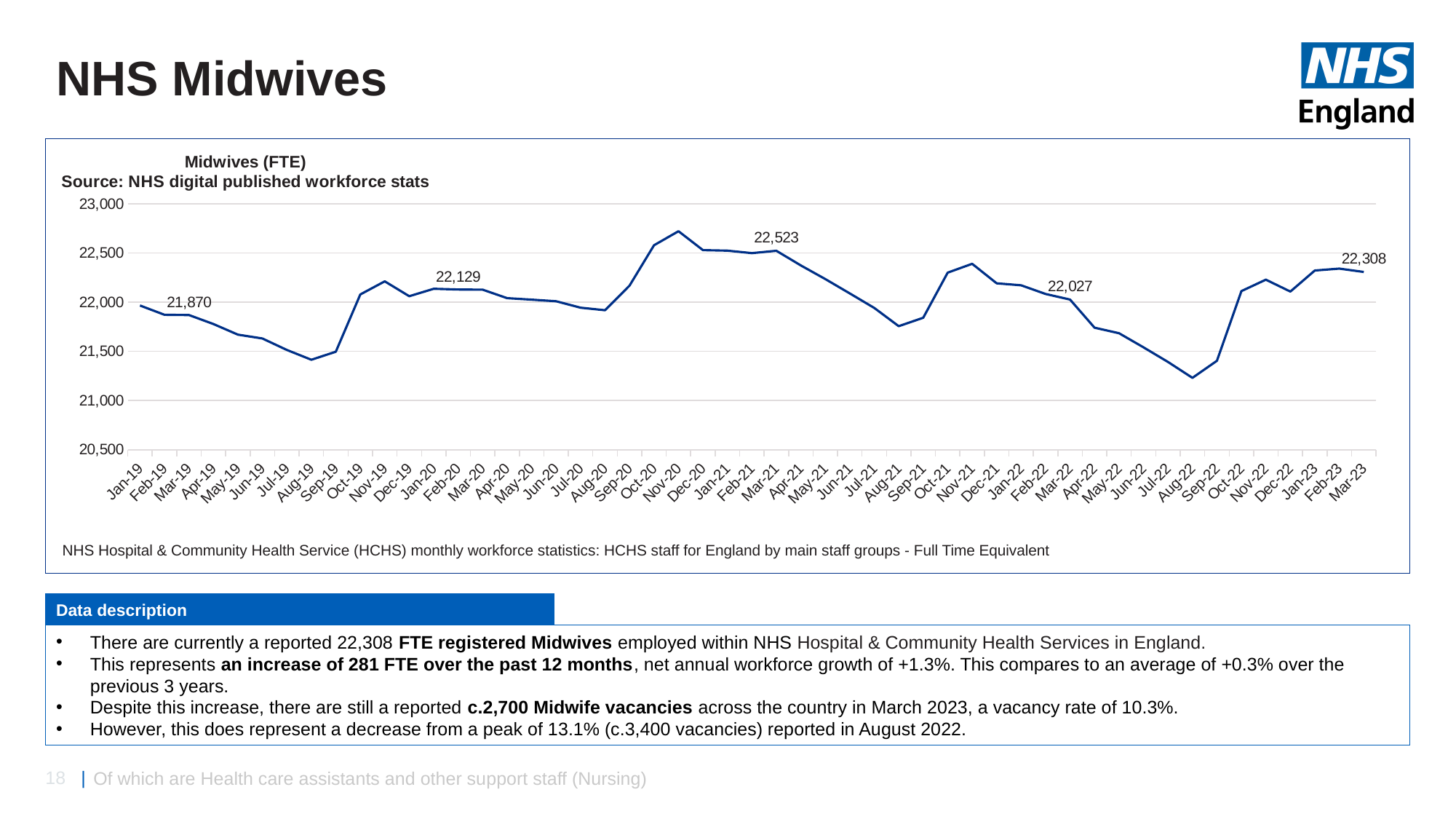
Is the Midwives (FTE) value for Nov-20 greater or less than 22,500? greater What is the Midwives (FTE) value for Mar-23? 22,308 By how much did the Midwives (FTE) value increase from Mar-22 to Mar-23? 281 Which is larger, the Midwives (FTE) value for Mar-21 or for Mar-22? Mar-21 According to the chart subtitle, what is the source of the Midwives (FTE) data? NHS digital published workforce stats What is the Midwives (FTE) value for Mar-21? 22,523 Is the Midwives (FTE) value for Aug-22 greater or less than 21,500? less What kind of chart is shown on the slide? line chart What is the difference between the Mar-21 and Mar-20 Midwives (FTE) values? 394 What is the Midwives (FTE) value for Mar-22? 22,027 What is the Midwives (FTE) value for Mar-20? 22,129 What is the Midwives (FTE) value for Mar-19? 21,870